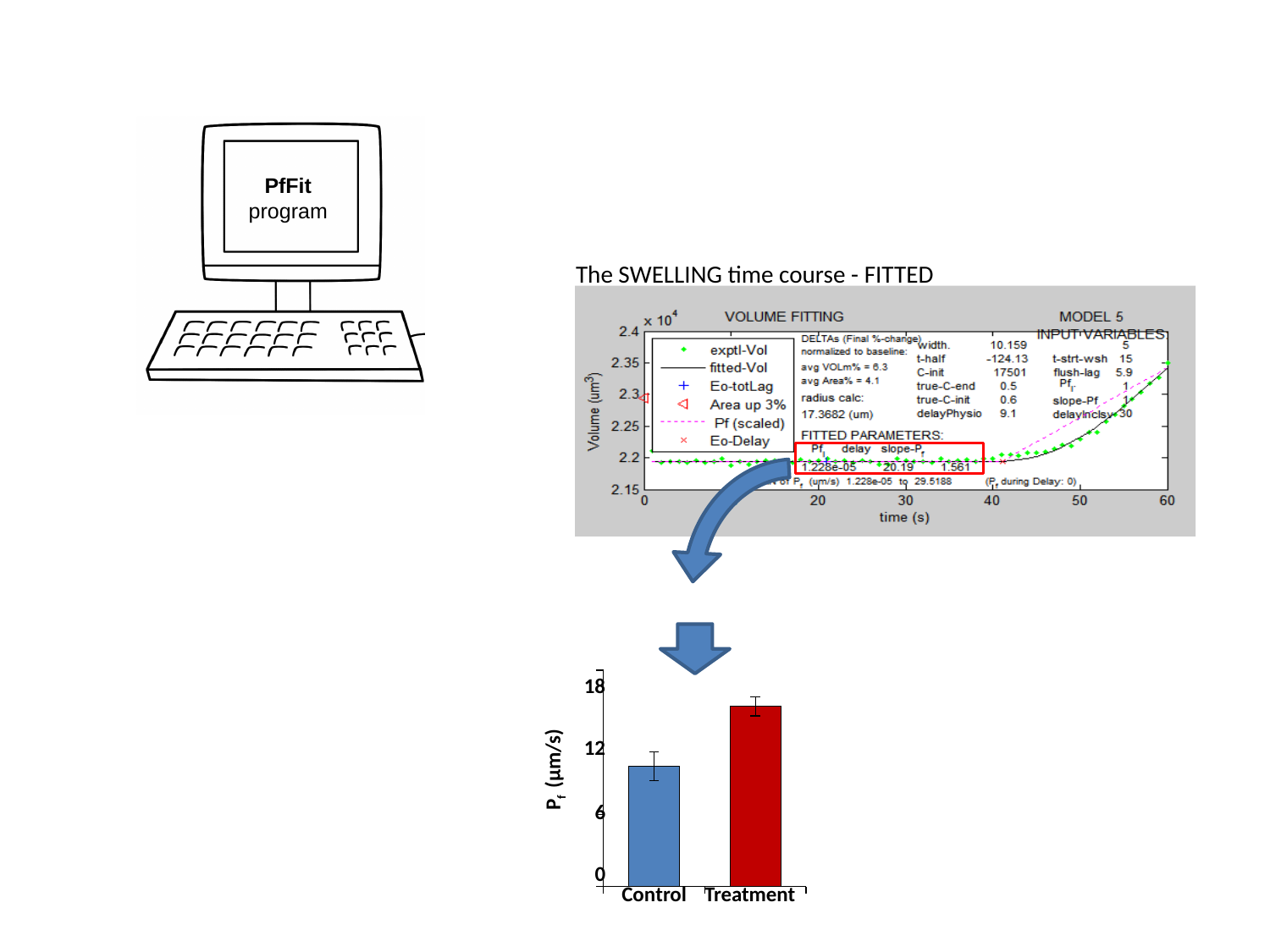
In the lower bar chart, is the value for Treatment greater or less than 12? greater What kind of chart is the lower chart with Control and Treatment? bar chart In the VOLUME FITTING chart, what is the fitted Pf value shown in the FITTED PARAMETERS box? 1.228e-05 In the VOLUME FITTING chart, does the volume rise or fall between 40 s and 60 s? rise In the lower bar chart, is the value for Control greater or less than 12? less In the lower bar chart, how many categories are shown on the x axis? 2 In the lower bar chart, what colour is the Treatment bar? red In the lower bar chart, is the Treatment bar larger or smaller than the Control bar? larger In the lower bar chart, is the value for Treatment greater or less than 18? less In the lower bar chart, which category has the lower Pf value? Control In the lower bar chart, which category has the higher Pf value? Treatment In the VOLUME FITTING chart, how many entries does the legend list? 6